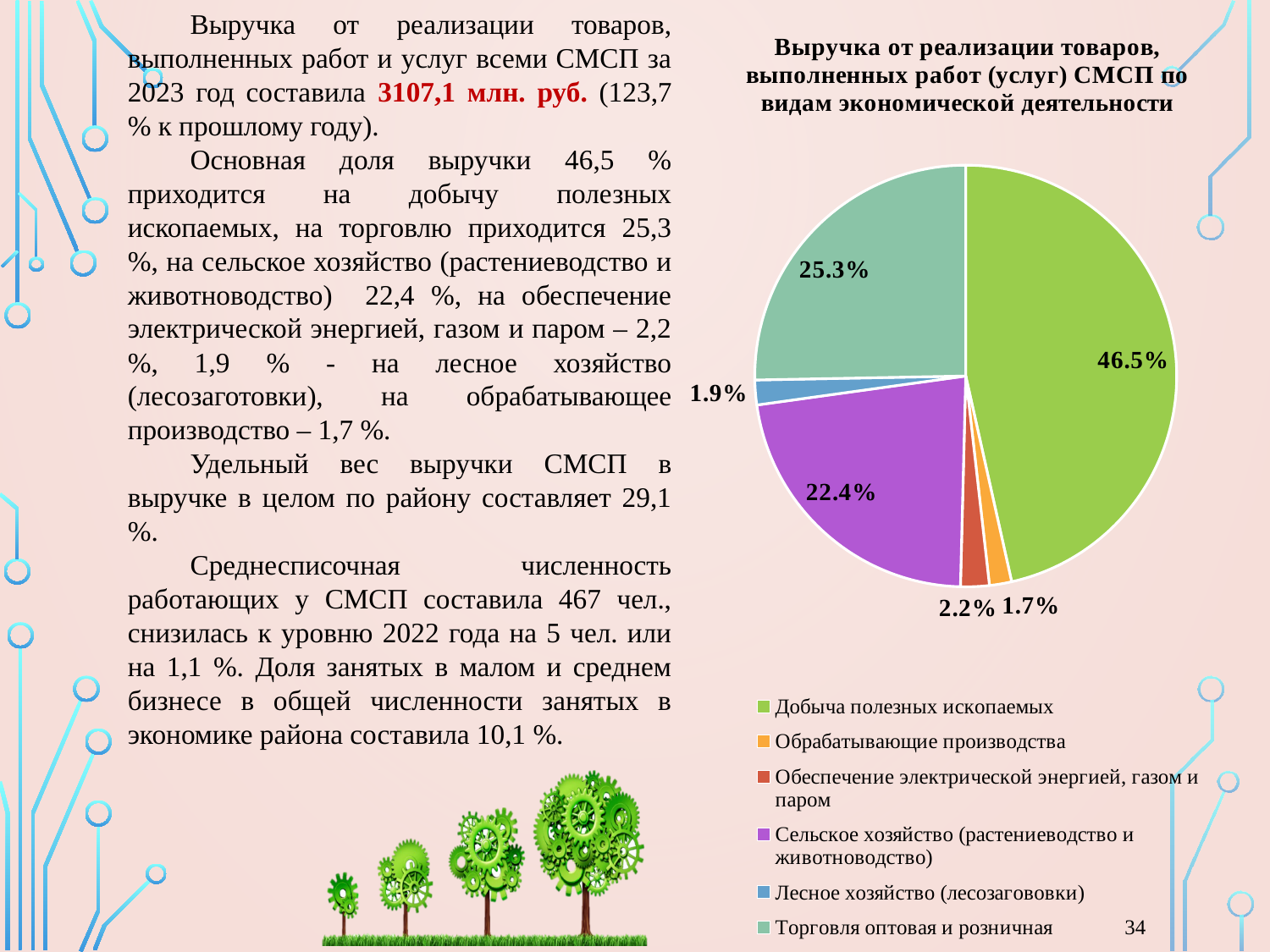
What type of chart is shown on the slide? pie chart Which category has the largest slice in the pie chart? Добыча полезных ископаемых What is the difference between the shares of Торговля оптовая и розничная and Сельское хозяйство (растениеводство и животноводство)? 2.9% What value is shown for Торговля оптовая и розничная in the pie chart? 25.3% Which category has the smallest slice in the pie chart? Обрабатывающие производства Which is larger in the pie chart: Обеспечение электрической энергией, газом и паром or Лесное хозяйство (лесозаговки)? Обеспечение электрической энергией, газом и паром How many categories does the pie chart legend list? 6 What share of the pie chart does Добыча полезных ископаемых have? 46.5% What value is shown for Обрабатывающие производства in the pie chart? 1.7% What value is shown for Сельское хозяйство (растениеводство и животноводство) in the pie chart? 22.4% What value is shown for Лесное хозяйство (лесозаговки) in the pie chart? 1.9% What colour is the slice for Сельское хозяйство (растениеводство и животноводство) in the pie chart? purple